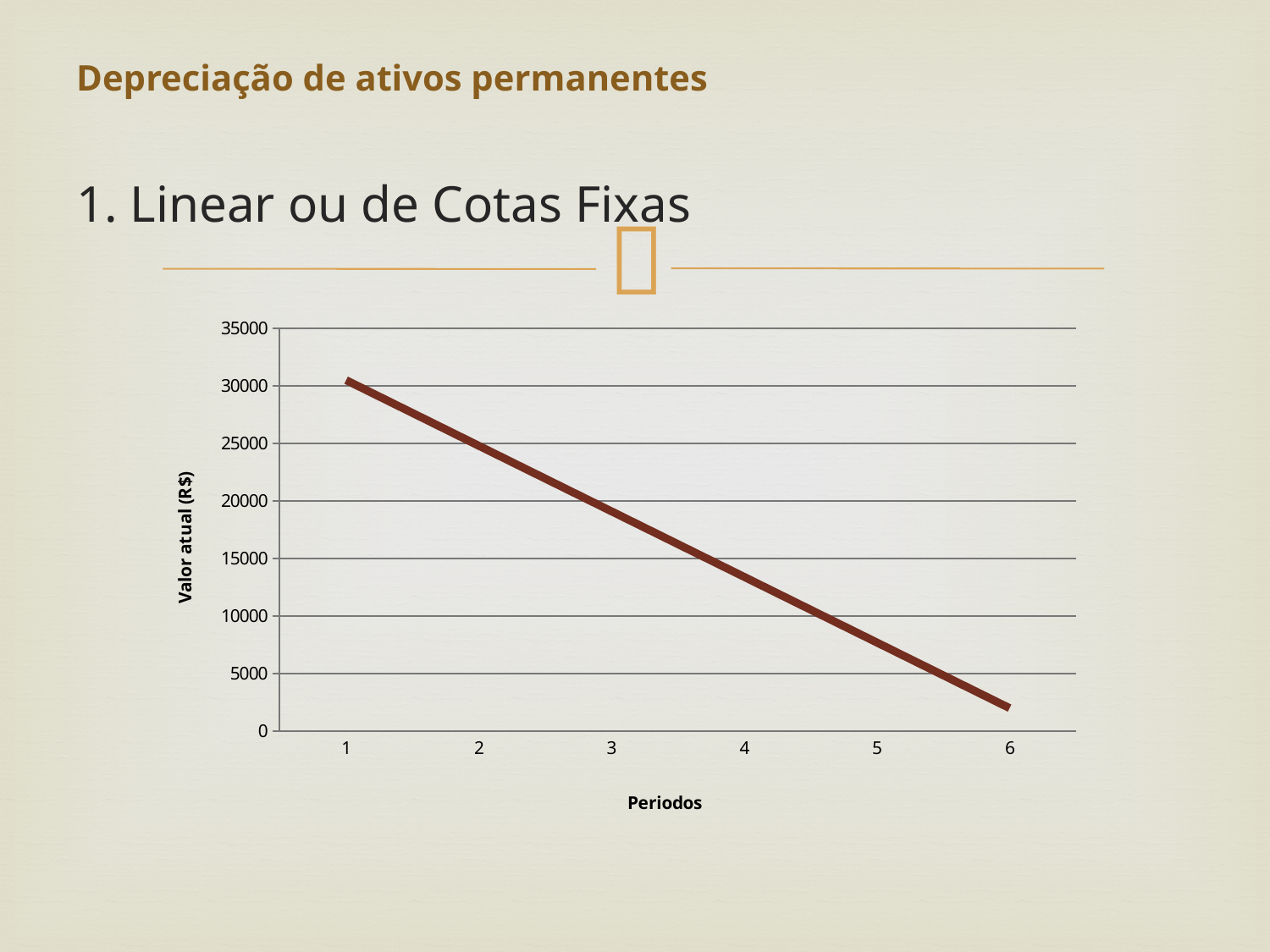
Which period has the lowest value? 6 Do the values rise or fall as the period number increases? fall Which has the larger value, period 2 or period 5? period 2 Is the value for period 6 greater or less than 5000? less What kind of chart is shown on the slide? line chart What is the label of the horizontal axis? Periodos Is the value for period 5 greater or less than 10000? less Is the value for period 1 greater or less than 25000? greater How many periods are plotted along the x axis? 6 Which period has the highest value? 1 What is the label of the vertical axis? Valor atual (R$)